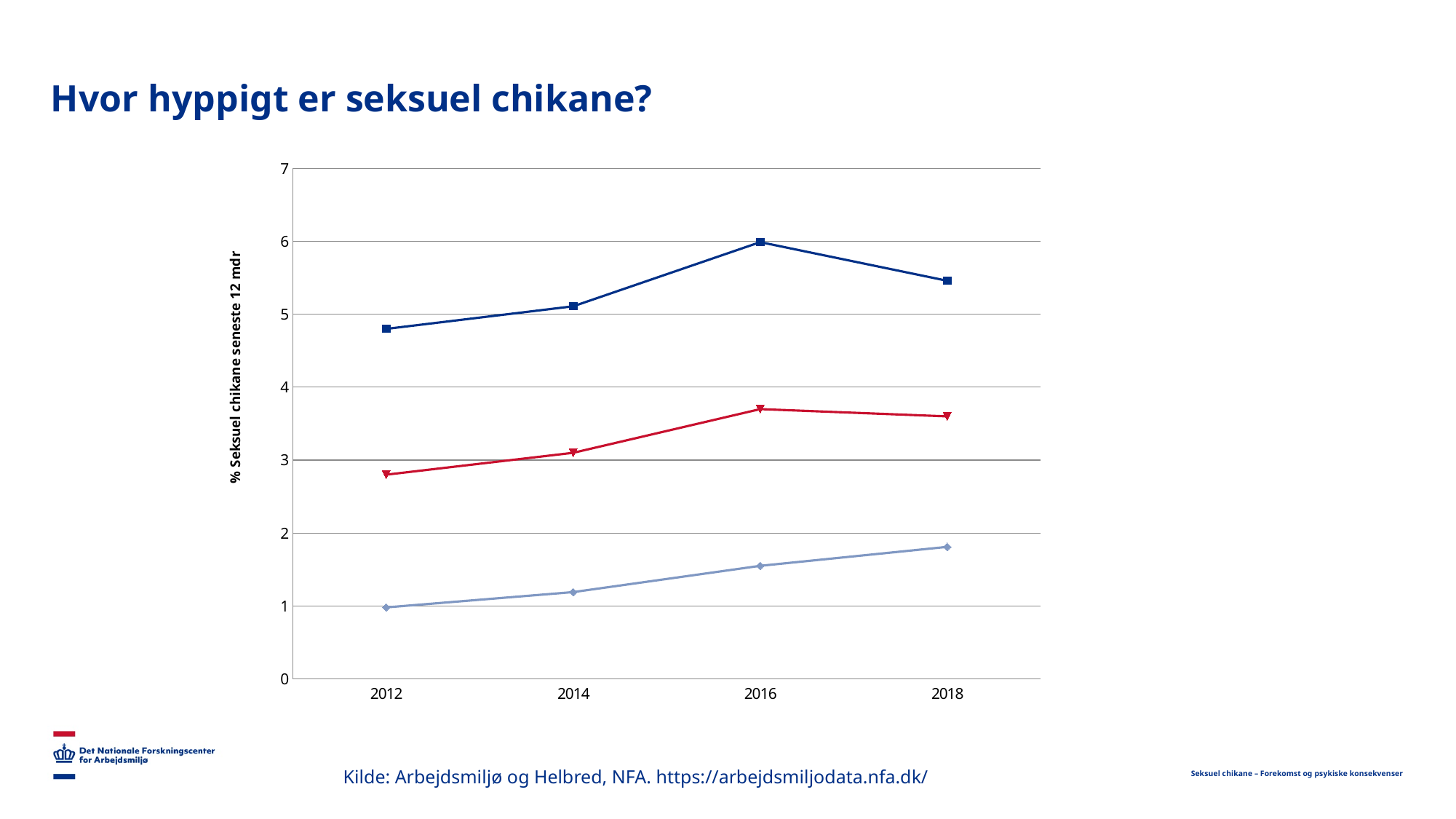
In which year does the dark blue line with square markers reach its highest value? 2016 In which year does the light blue line with diamond markers reach its highest value? 2018 In which year is the red line with triangle markers at its lowest value? 2012 What is the title of the slide containing the chart? Hvor hyppigt er seksuel chikane? Is the value of the red line in 2012 greater or less than 3? less How many years are shown on the x axis of the chart? 4 What kind of chart is shown on the slide? line chart Does the light blue line with diamond markers rise or fall from 2012 to 2018? rise Is the value of the light blue line in 2018 greater or less than 2? less In 2018, which line has the larger value, the dark blue line or the red line? the dark blue line Is the value of the dark blue line in 2016 greater or less than 5? greater What is the label on the vertical axis of the chart? % Seksuel chikane seneste 12 mdr